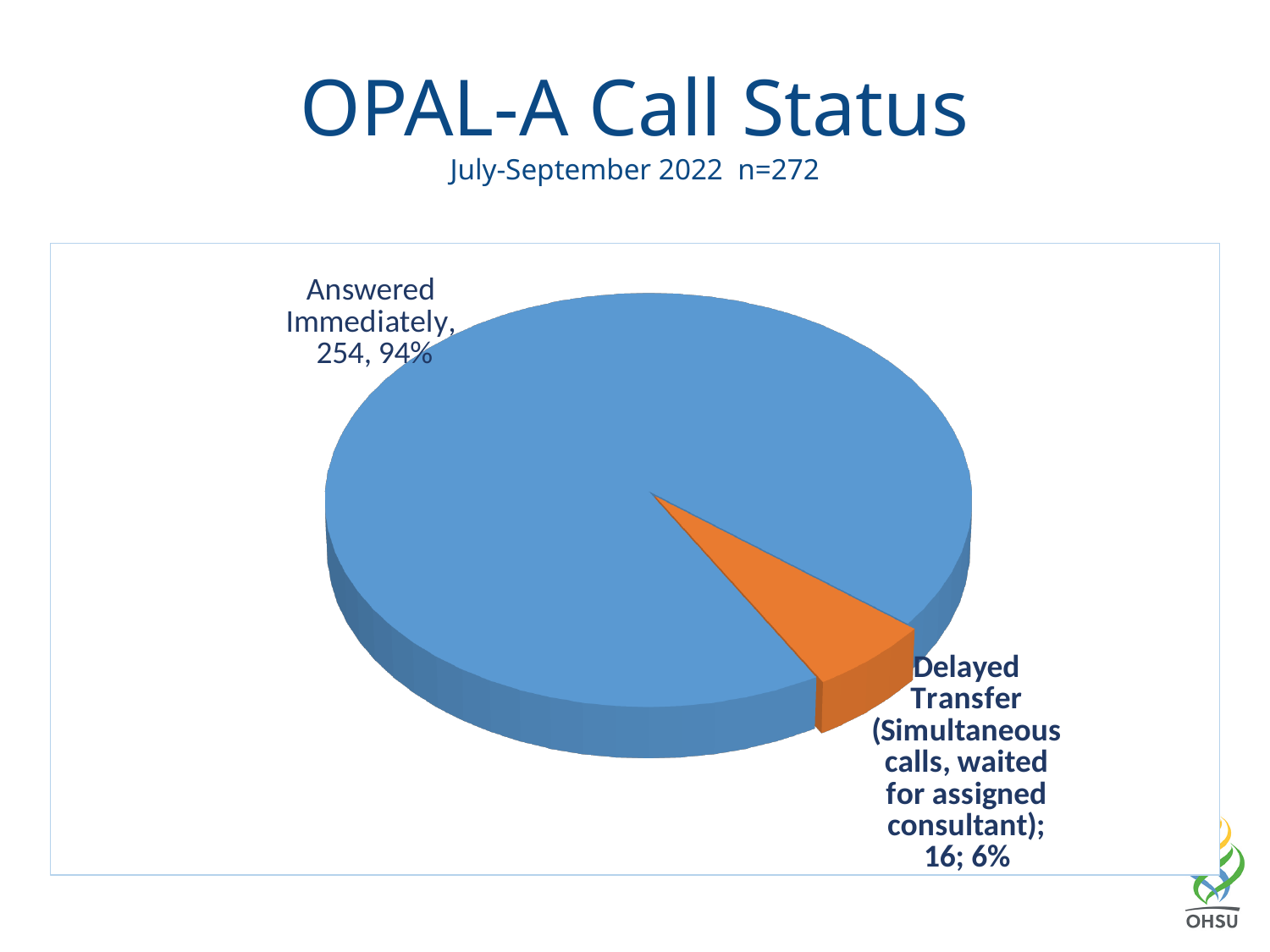
Which is larger, the number of calls Answered Immediately or the number with Delayed Transfer? Answered Immediately What is the total number of calls represented in the chart? 272 What share of the pie does Delayed Transfer represent? 6% What is the difference in number of calls between Answered Immediately and Delayed Transfer? 238 What percentage of calls were Answered Immediately? 94% What kind of chart is shown on the slide? Pie chart Which category has the smallest slice of the pie? Delayed Transfer Which category has the largest slice of the pie? Answered Immediately How many calls were Answered Immediately? 254 How many categories are shown in the pie chart? 2 What colour is the Delayed Transfer slice? Orange How many calls had a Delayed Transfer? 16